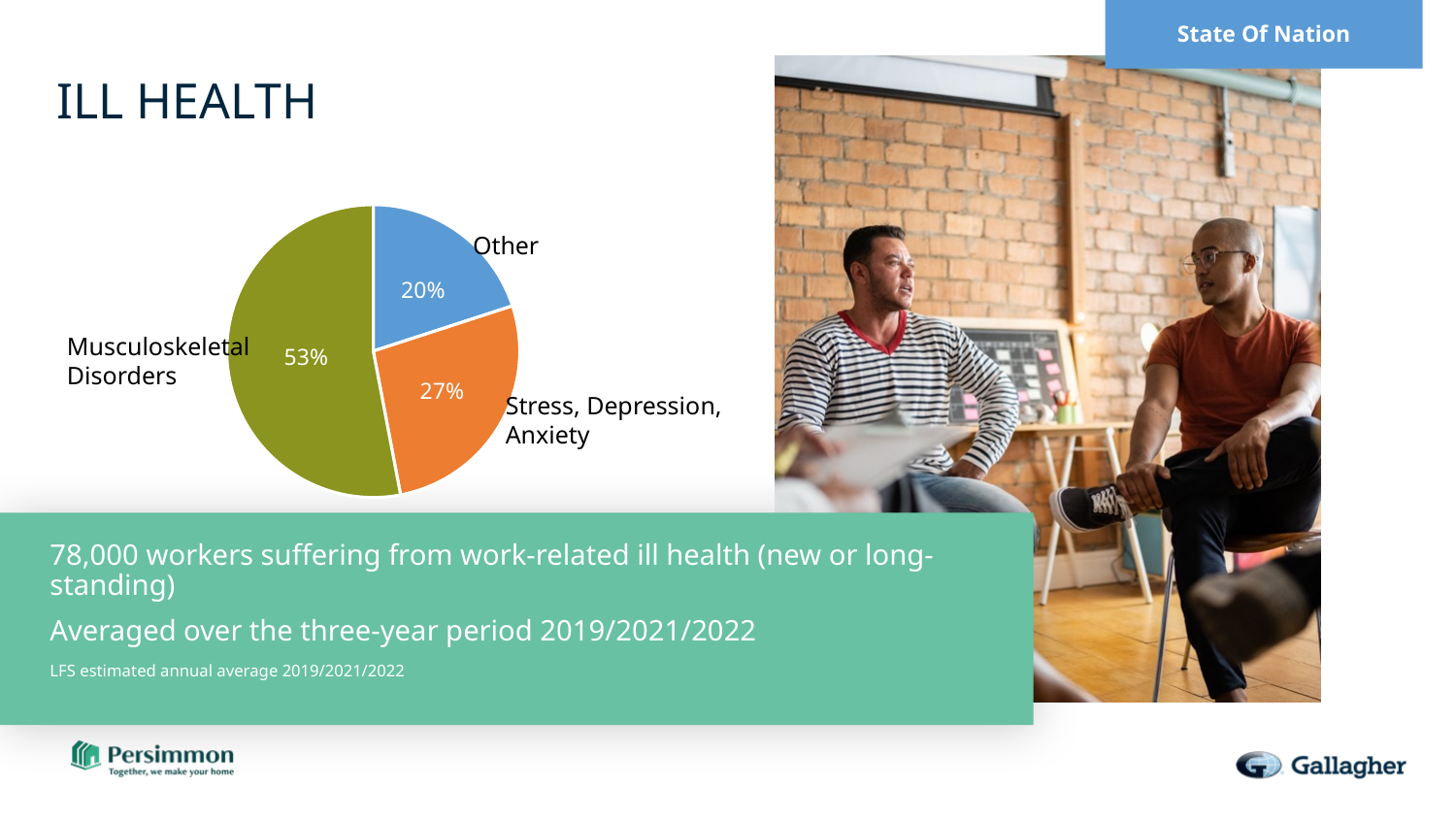
Which is larger: the share for Stress, Depression, Anxiety or the share for Other? Stress, Depression, Anxiety What percentage of the pie chart is Musculoskeletal Disorders? 53% What colour is the Musculoskeletal Disorders slice of the pie chart? Green Is the share for Musculoskeletal Disorders greater or less than 50%? greater What percentage of the pie chart is Stress, Depression, Anxiety? 27% Which category has the smallest share of the pie chart? Other What kind of chart is shown on the slide? Pie chart Which category has the largest share of the pie chart? Musculoskeletal Disorders How many categories are shown in the pie chart? 3 What percentage of the pie chart is Other? 20% What is the difference in percentage points between Musculoskeletal Disorders and Stress, Depression, Anxiety? 26 What is the difference in percentage points between Stress, Depression, Anxiety and Other? 7